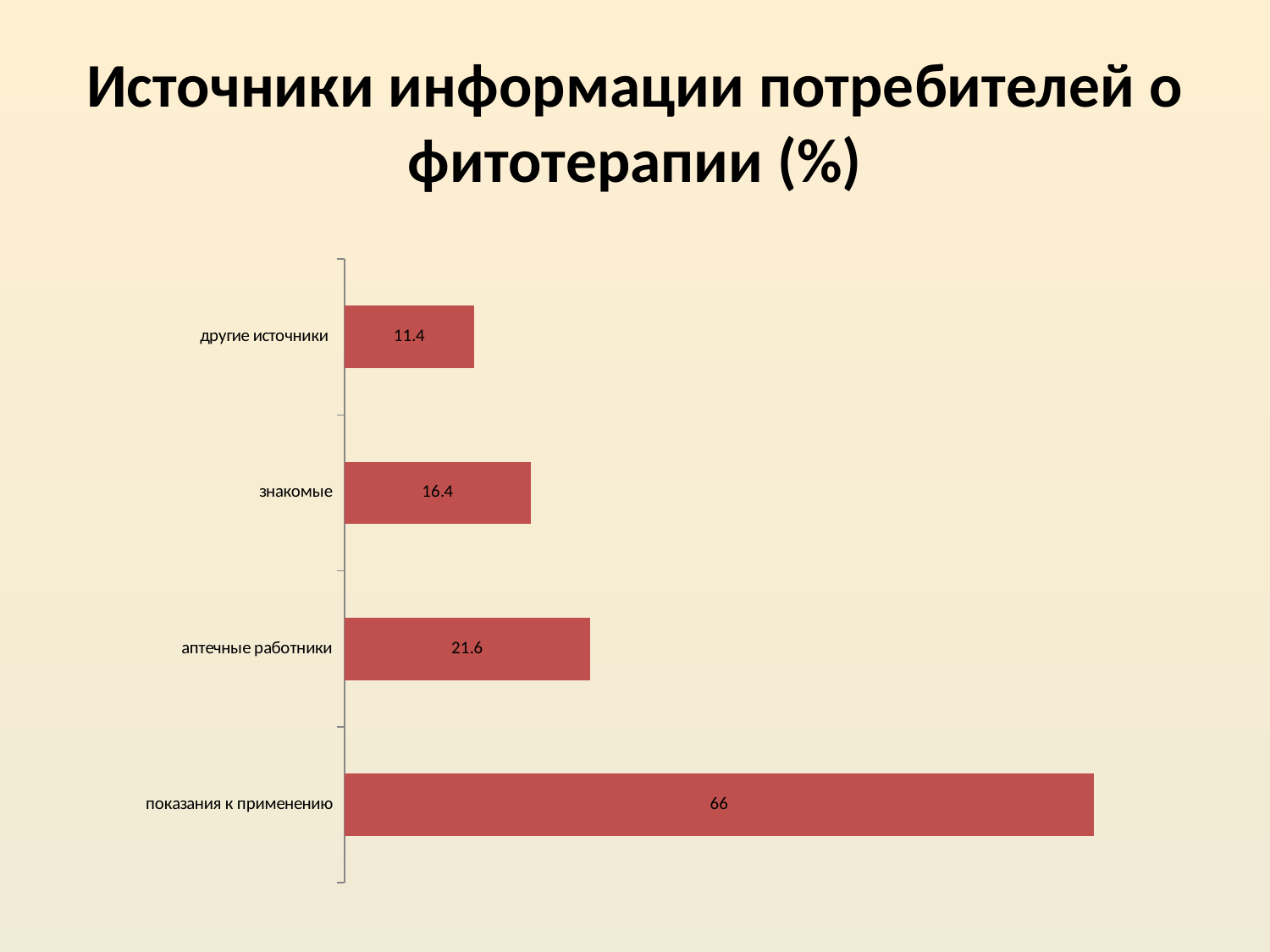
How many categories are shown in the chart? 4 What is the difference between the values for "показания к применению" and "аптечные работники"? 44.4 What is the value for "другие источники"? 11.4 Which is larger, the value for "аптечные работники" or the value for "знакомые"? аптечные работники What is the value for "аптечные работники"? 21.6 What kind of chart is shown on the slide? bar chart What is the title of the slide? Источники информации потребителей о фитотерапии (%) What is the difference between the values for "знакомые" and "другие источники"? 5 Which category has the lowest value? другие источники What is the value for "знакомые"? 16.4 What is the value for "показания к применению"? 66 Which category has the highest value? показания к применению